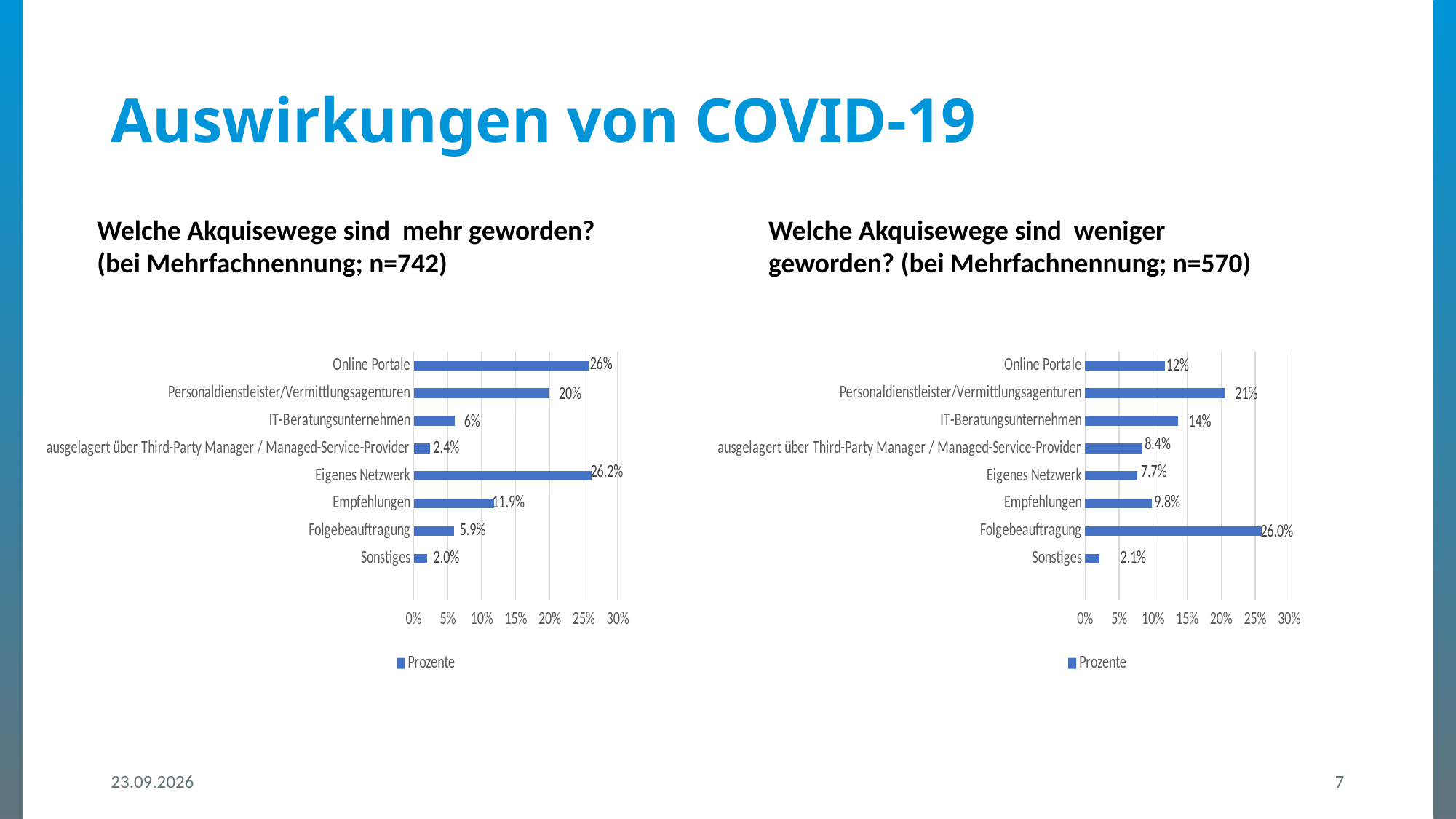
In the left chart (Welche Akquisewege sind mehr geworden?), what is the value for Personaldienstleister/Vermittlungsagenturen? 20% In the right chart (Welche Akquisewege sind weniger geworden?), what is the difference between Personaldienstleister/Vermittlungsagenturen and Online Portale? 9% In the left chart (Welche Akquisewege sind mehr geworden?), what is the difference between Online Portale and IT-Beratungsunternehmen? 20% In the right chart (Welche Akquisewege sind weniger geworden?), what is the value for Eigenes Netzwerk? 7.7% In the right chart (Welche Akquisewege sind weniger geworden?), what is the value for Folgebeauftragung? 26.0% What is the legend entry shown below the left chart (Welche Akquisewege sind mehr geworden?)? Prozente In the right chart (Welche Akquisewege sind weniger geworden?), which category has the lowest value? Sonstiges How many categories does the left chart (Welche Akquisewege sind mehr geworden?) show? 8 What type of chart is the right chart (Welche Akquisewege sind weniger geworden?)? Bar chart In the left chart (Welche Akquisewege sind mehr geworden?), what is the value for Empfehlungen? 11.9% In the right chart (Welche Akquisewege sind weniger geworden?), which category has the highest value? Folgebeauftragung In the left chart (Welche Akquisewege sind mehr geworden?), which is larger: Empfehlungen or Folgebeauftragung? Empfehlungen